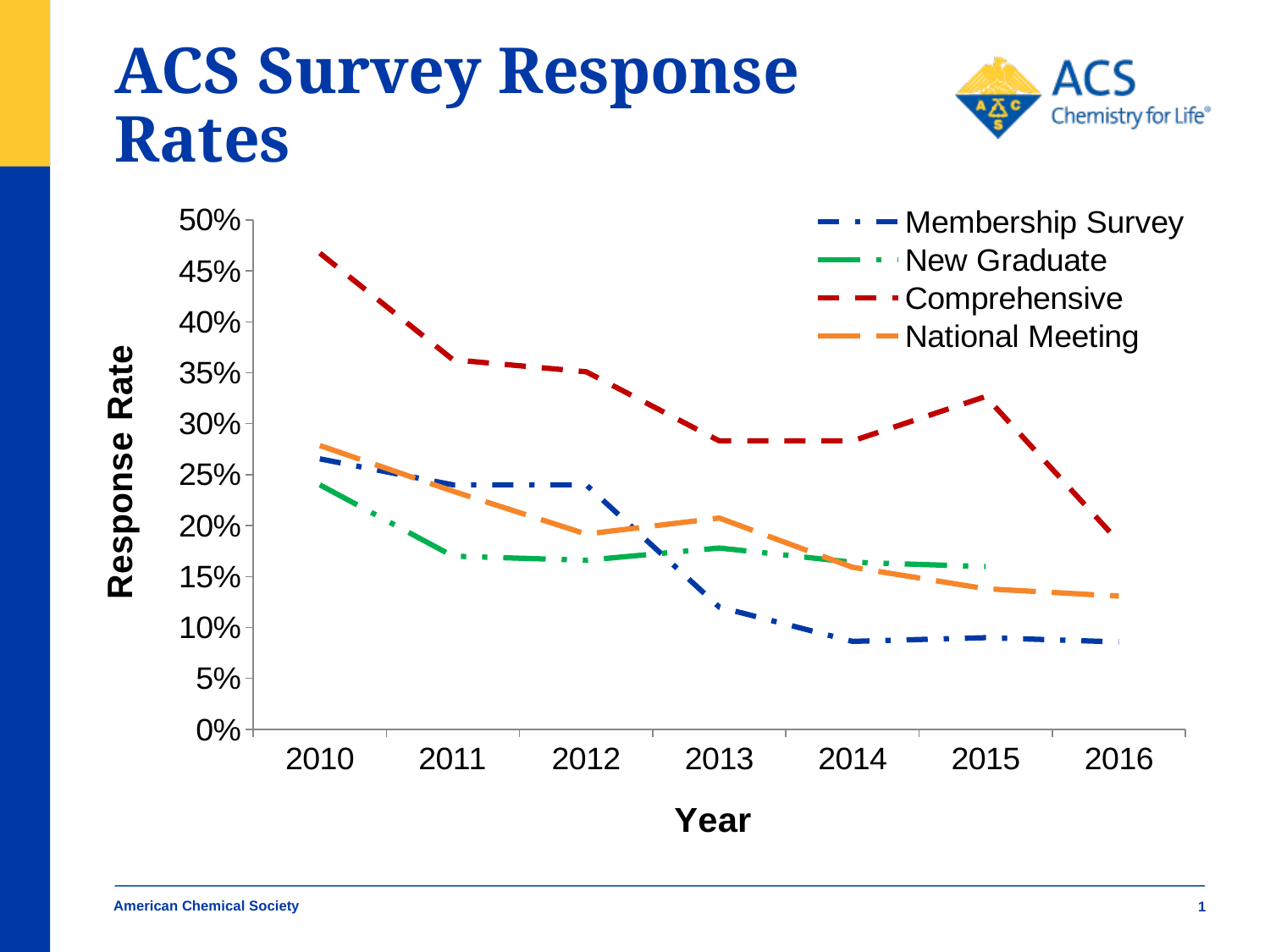
Does the Membership Survey response rate rise or fall from 2010 to 2016? Fall Which survey had the highest response rate in 2013? Comprehensive Is the Comprehensive response rate in 2016 greater or less than 25%? less In 2010, which had the higher response rate: Comprehensive or National Meeting? Comprehensive How many years are shown along the x axis? 7 How many series does the legend list? 4 Is the National Meeting response rate in 2010 greater or less than 25%? greater What kind of chart is shown on the slide? Line chart Is the Comprehensive response rate in 2010 greater or less than 40%? greater What is the title of the y axis? Response Rate Which survey had the lowest response rate in 2016? Membership Survey